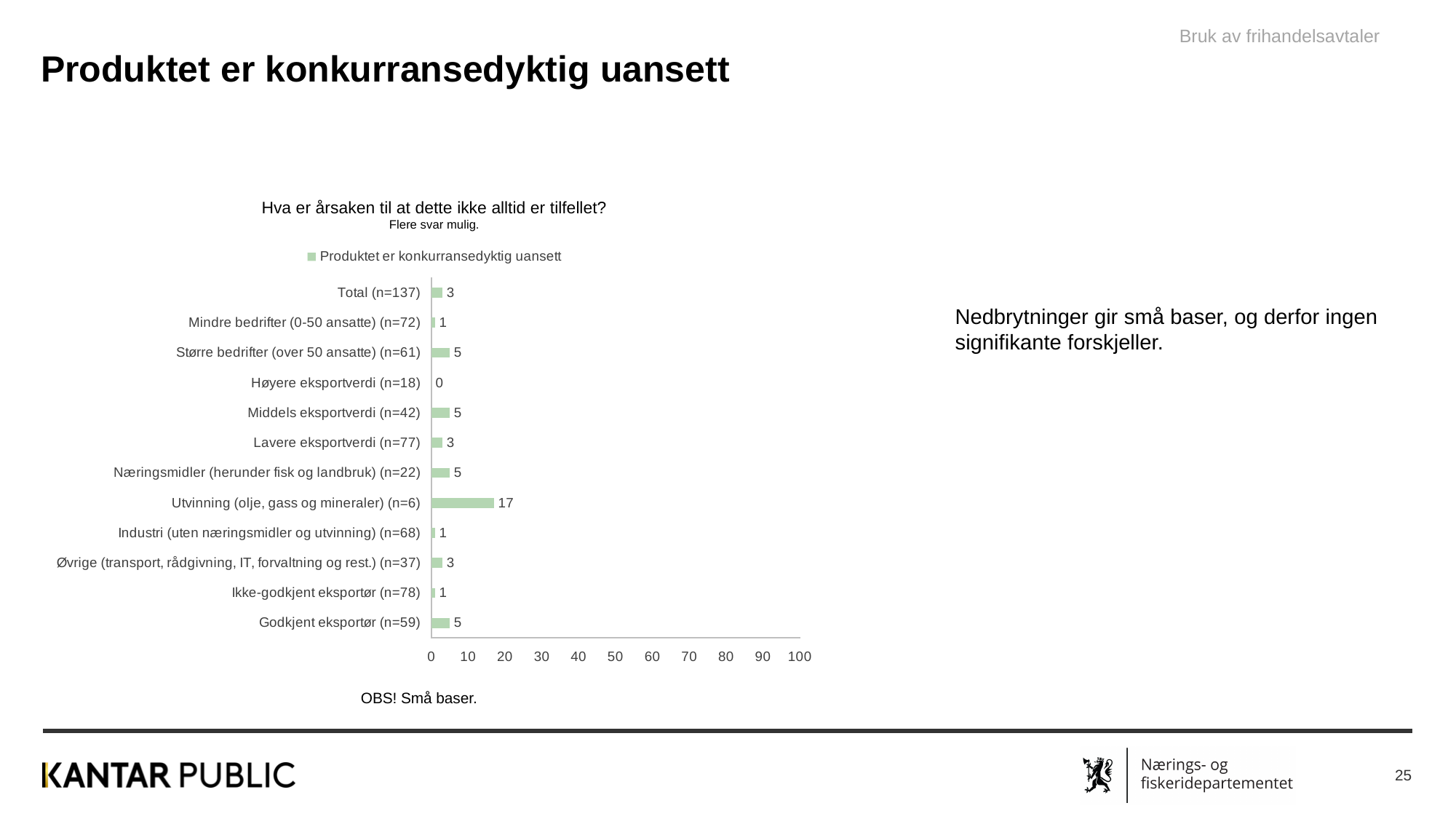
What is the value for Godkjent eksportør (n=59)? 5 Is the value for Utvinning (olje, gass og mineraler) (n=6) greater or less than 20? less Which category has the lowest value? Høyere eksportverdi (n=18) What is the legend entry of the series shown in the chart? Produktet er konkurransedyktig uansett What is the value for Høyere eksportverdi (n=18)? 0 Which category has the highest value? Utvinning (olje, gass og mineraler) (n=6) What is the difference between the values for Utvinning (olje, gass og mineraler) (n=6) and Total (n=137)? 14 Which is larger, the value for Større bedrifter (over 50 ansatte) (n=61) or Mindre bedrifter (0-50 ansatte) (n=72)? Større bedrifter (over 50 ansatte) (n=61) How many categories are shown in the chart? 12 What is the value for Total (n=137)? 3 What is the value for Utvinning (olje, gass og mineraler) (n=6)? 17 What kind of chart is shown on the slide? bar chart